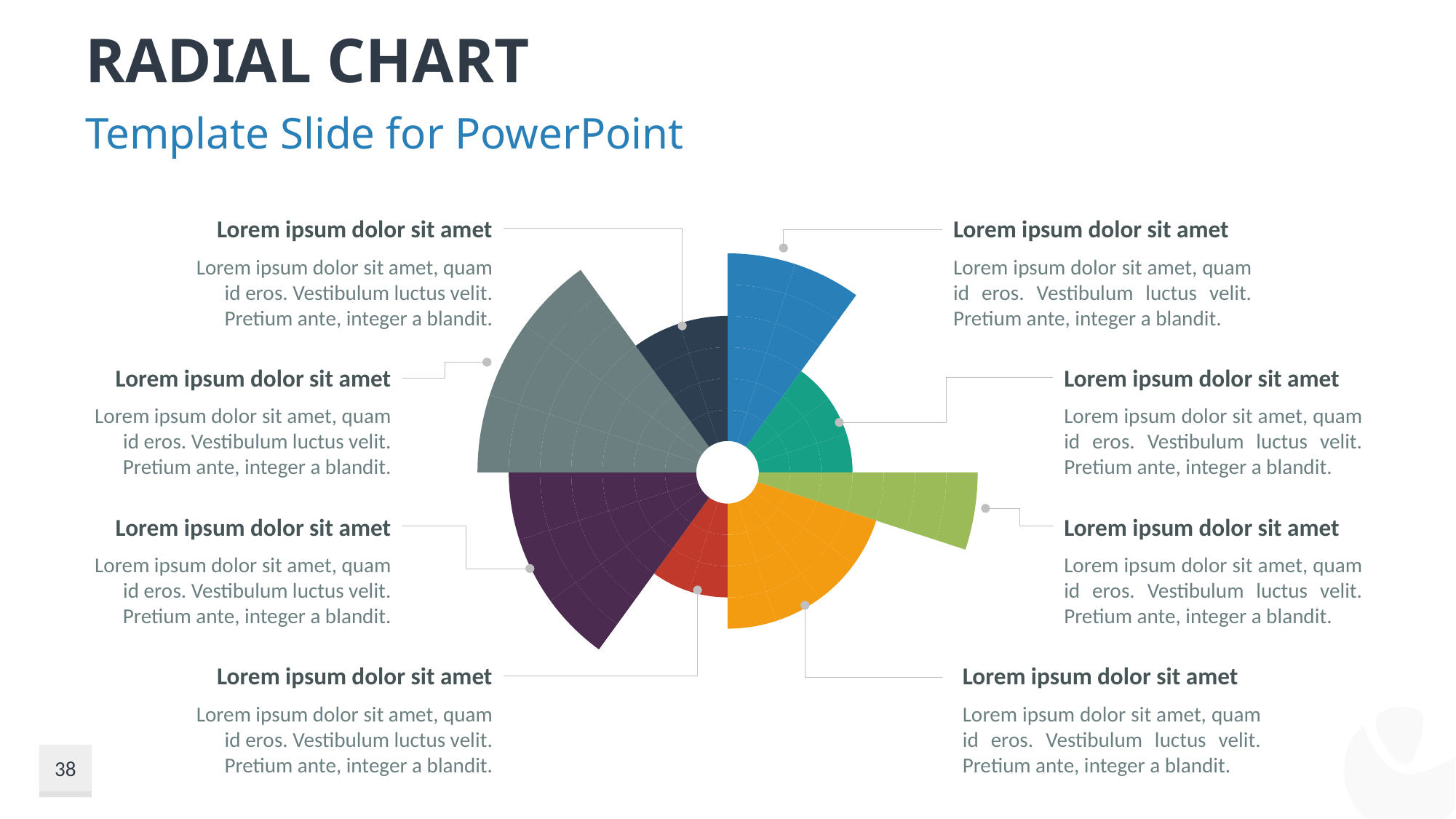
Which extends further from the centre: the blue segment or the green segment? Blue Which extends further from the centre: the light green segment or the orange segment? Light green Which extends further from the centre: the dark navy segment or the grey segment? Grey What kind of chart is shown on the slide? Radial chart How many segments does the radial chart have? 8 How many text callouts are placed around the radial chart? 8 What is the title of the slide containing the chart? Radial Chart